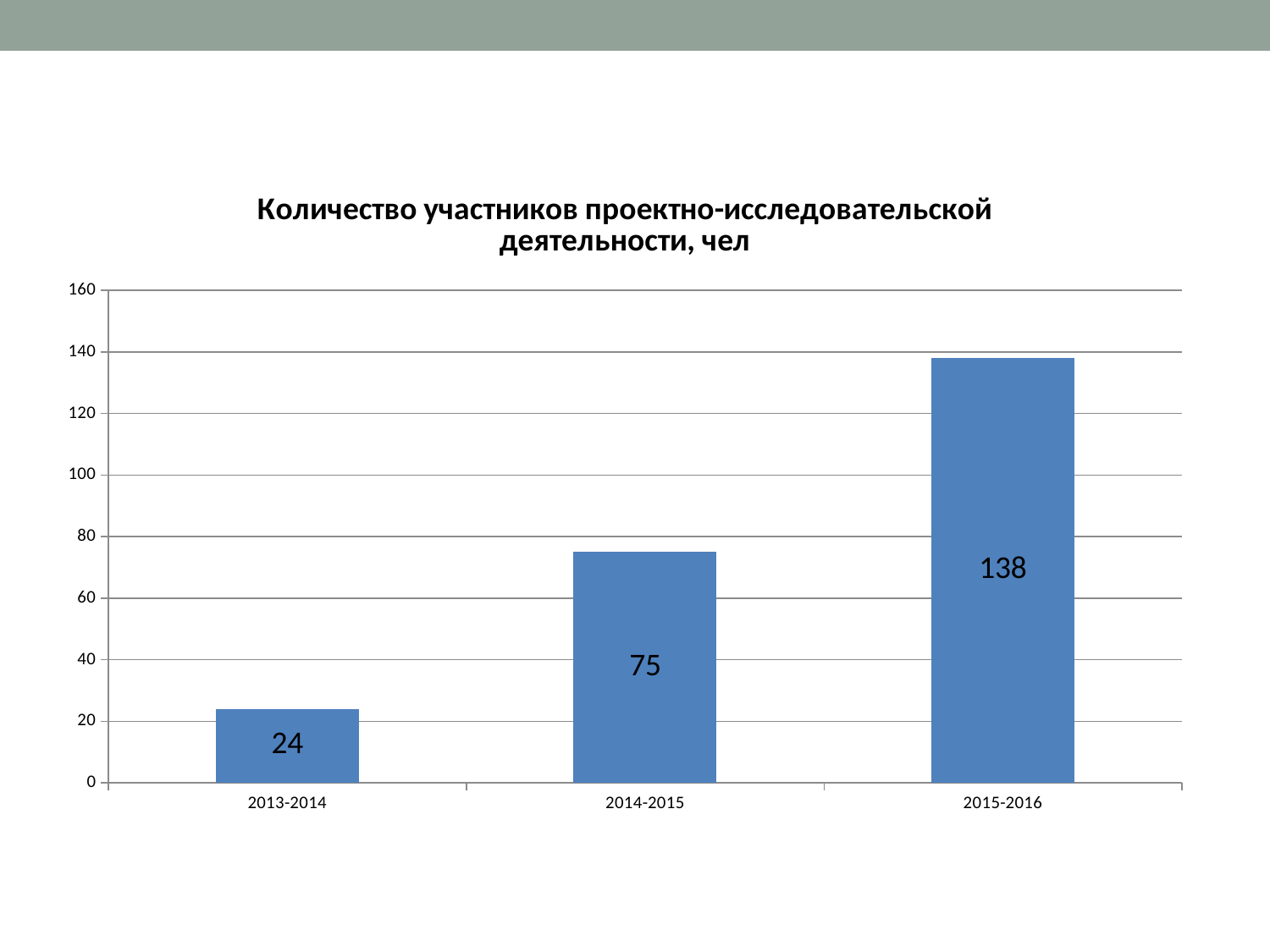
How many categories are shown on the x axis? 3 Do the values rise or fall from 2013-2014 to 2015-2016? rise Which category has the highest value? 2015-2016 What is the value for 2015-2016? 138 What is the value for 2014-2015? 75 What is the difference between the values for 2014-2015 and 2013-2014? 51 Is the value for 2015-2016 greater or less than 120? greater Which is larger, the value for 2013-2014 or the value for 2014-2015? 2014-2015 What is the difference between the values for 2015-2016 and 2014-2015? 63 What is the value for 2013-2014? 24 Which category has the lowest value? 2013-2014 What kind of chart is shown on the slide? bar chart